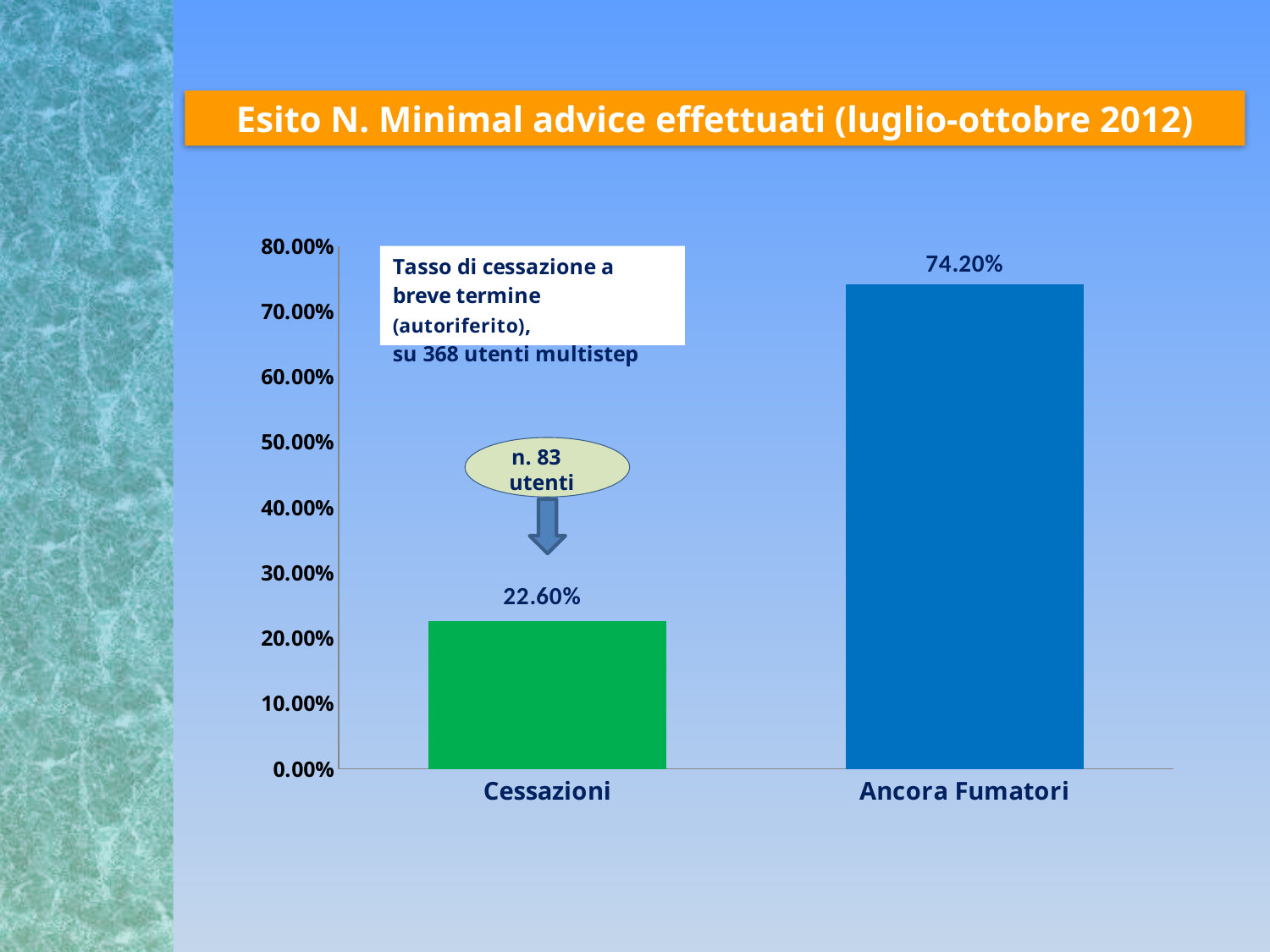
Which category has the lowest value? Cessazioni What is the difference between the values for Ancora Fumatori and Cessazioni? 51.60% Which category has the highest value? Ancora Fumatori What is the value for Ancora Fumatori? 74.20% What is the title of the slide? Esito N. Minimal advice effettuati (luglio-ottobre 2012) Is the value for Cessazioni greater or less than 30.00%? less What is the value for Cessazioni? 22.60% What kind of chart is shown on the slide? bar chart How many categories are shown on the x axis? 2 Which is larger, the value for Cessazioni or the value for Ancora Fumatori? Ancora Fumatori Is the value for Ancora Fumatori greater or less than 70.00%? greater What colour is the bar for Cessazioni? green